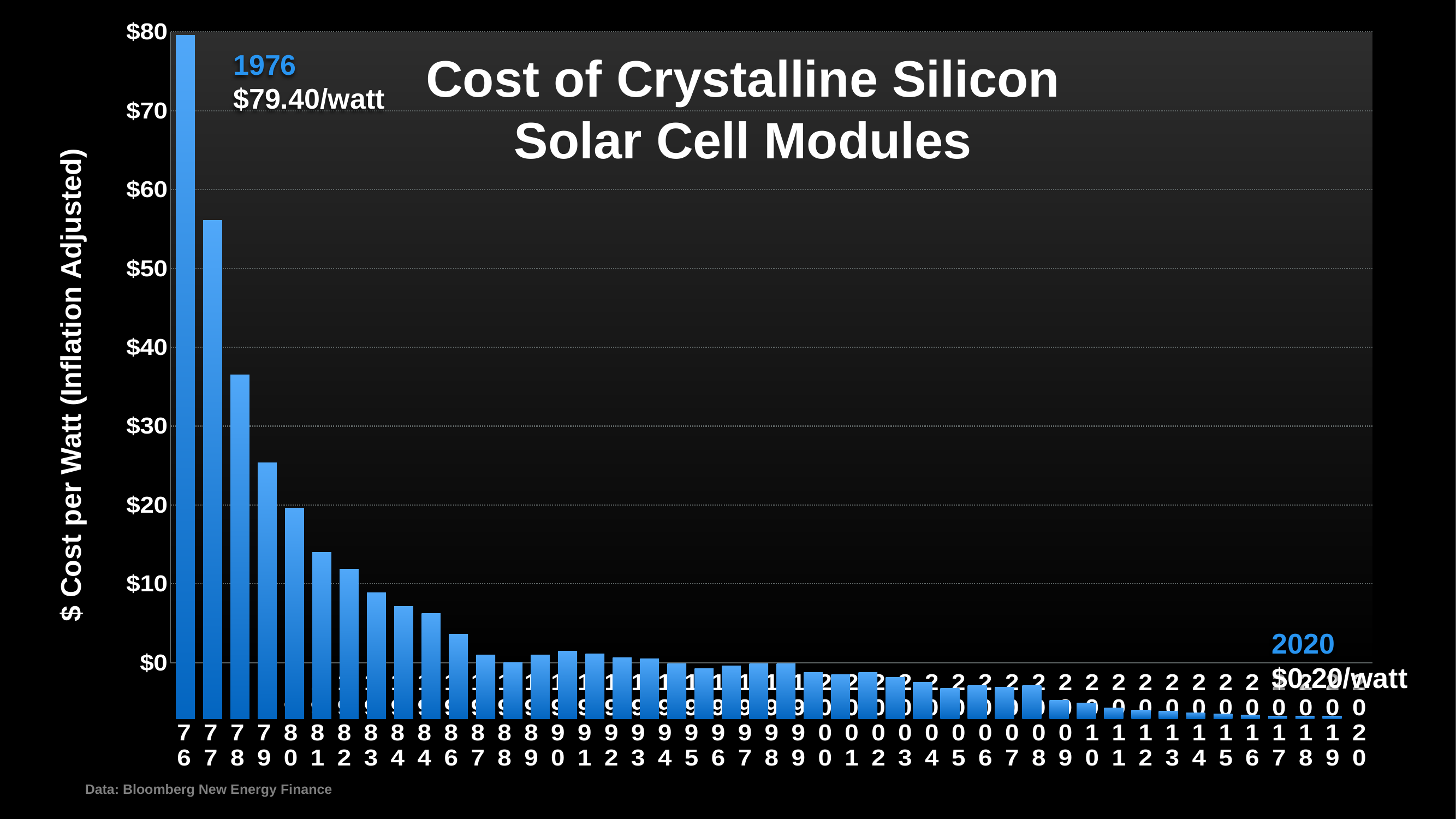
What is the difference between the 1976 cost per watt and the 2020 cost per watt? $79.20/watt Do the values rise or fall from 1976 to 2020? fall What kind of chart is shown on the slide? bar chart Is the value for 1978 greater or less than $40? less Which year has the highest cost per watt? 1976 What is the cost per watt shown for 2020? $0.20/watt Is the value for 1979 greater or less than $20? greater What is the cost per watt shown for 1976? $79.40/watt Is the value for 1983 greater or less than $10? less Which year has the larger cost per watt, 1977 or 1978? 1977 What is the title of the chart? Cost of Crystalline Silicon Solar Cell Modules